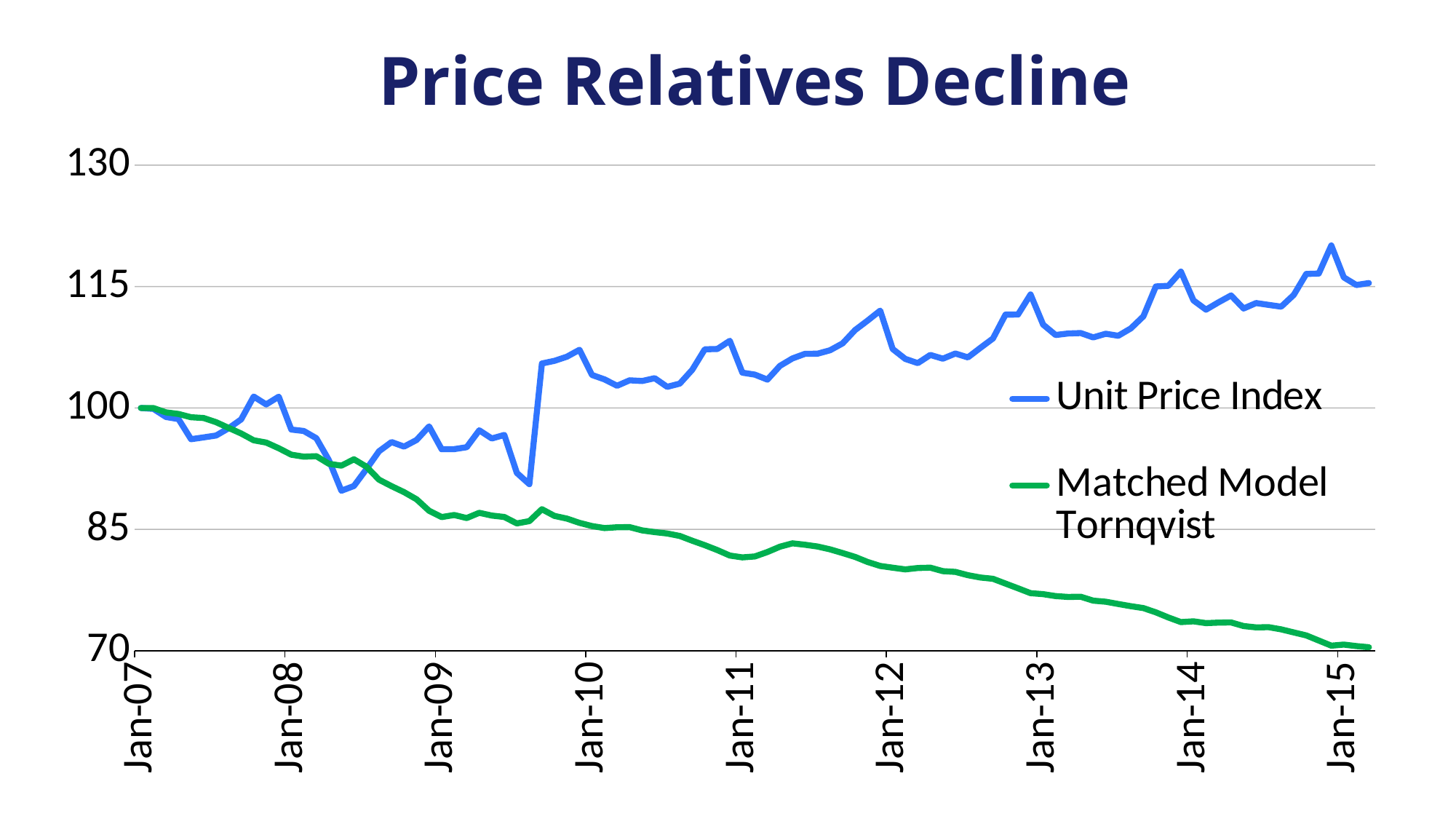
Is the value of the Unit Price Index at Jan-12 greater or less than 100? greater What is the value of the Matched Model Tornqvist series at Jan-07? 100 How many series does the legend list? 2 What type of chart is shown on the slide? line chart Is the value of the Matched Model Tornqvist series at Jan-15 greater or less than 85? less Which colour is used for the Matched Model Tornqvist series? green What is the value of the Unit Price Index at Jan-07? 100 How many year labels are shown on the x axis? 9 At Jan-13, which series has the higher value, Unit Price Index or Matched Model Tornqvist? Unit Price Index What is the title of the chart? Price Relatives Decline Does the Unit Price Index rise or fall overall from Jan-07 to Jan-15? rise Does the Matched Model Tornqvist series rise or fall from Jan-07 to Jan-15? fall